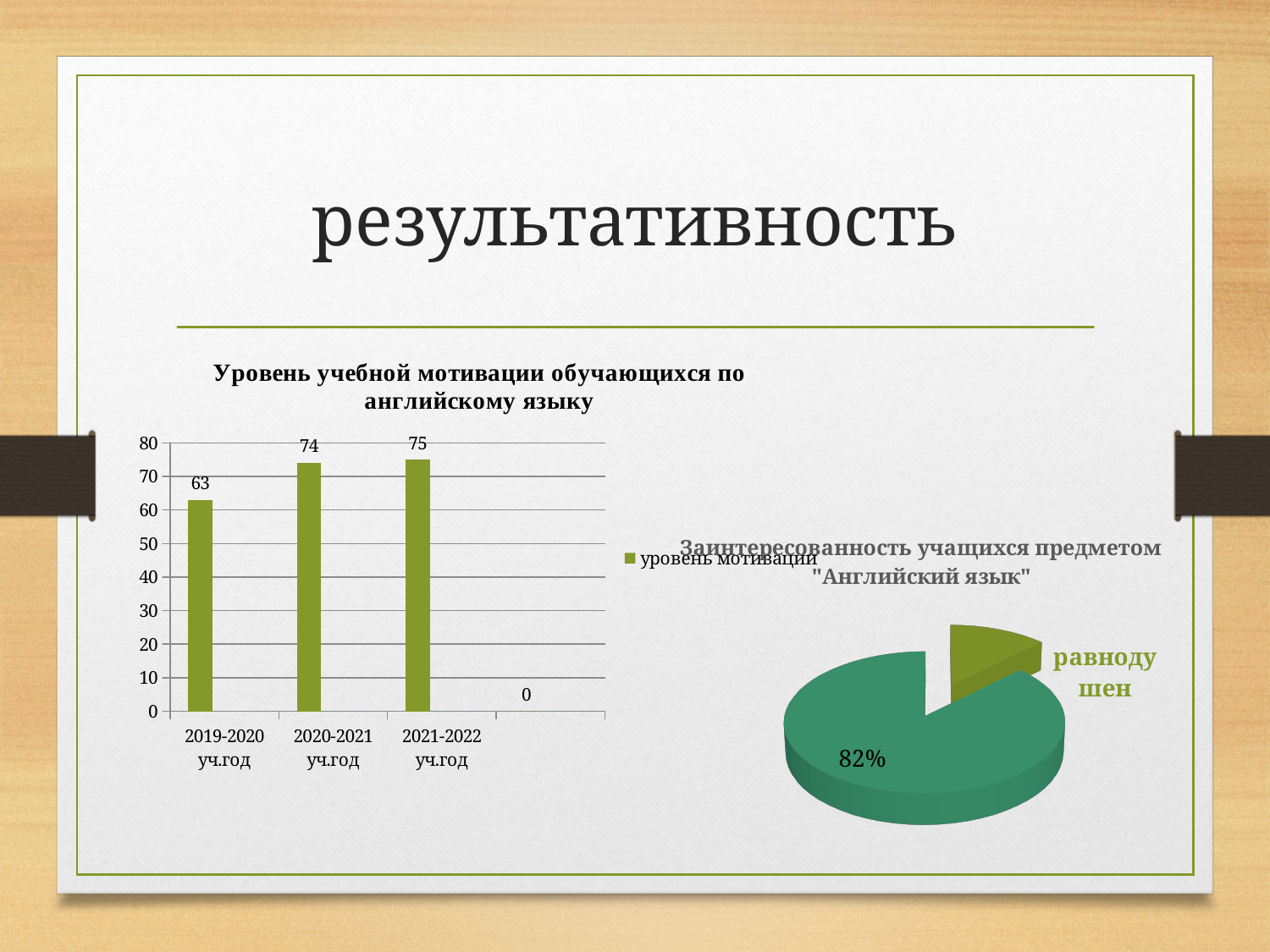
On the bar chart 'Уровень учебной мотивации обучающихся по английскому языку', what is the value for 2021-2022 уч.год? 75 On the bar chart on the left, which is larger: the value for 2020-2021 уч.год or for 2019-2020 уч.год? 2020-2021 уч.год On the bar chart on the left, which of the labelled school years has the lowest level of motivation? 2019-2020 уч.год On the pie chart 'Заинтересованность учащихся предметом "Английский язык"', what share does the large slice have? 82% On the bar chart on the left, what series name does the legend show? уровень мотивации What kind of chart is the chart on the right of the slide? pie chart On the bar chart on the left, which school year has the highest level of motivation? 2021-2022 уч.год On the bar chart on the left, what is the difference between the values for 2021-2022 уч.год and 2019-2020 уч.год? 12 On the bar chart 'Уровень учебной мотивации обучающихся по английскому языку', what is the value for 2019-2020 уч.год? 63 On the bar chart on the left, do the values rise or fall from 2019-2020 to 2021-2022? rise What kind of chart is the chart on the left of the slide? bar chart On the bar chart 'Уровень учебной мотивации обучающихся по английскому языку', what is the value for 2020-2021 уч.год? 74